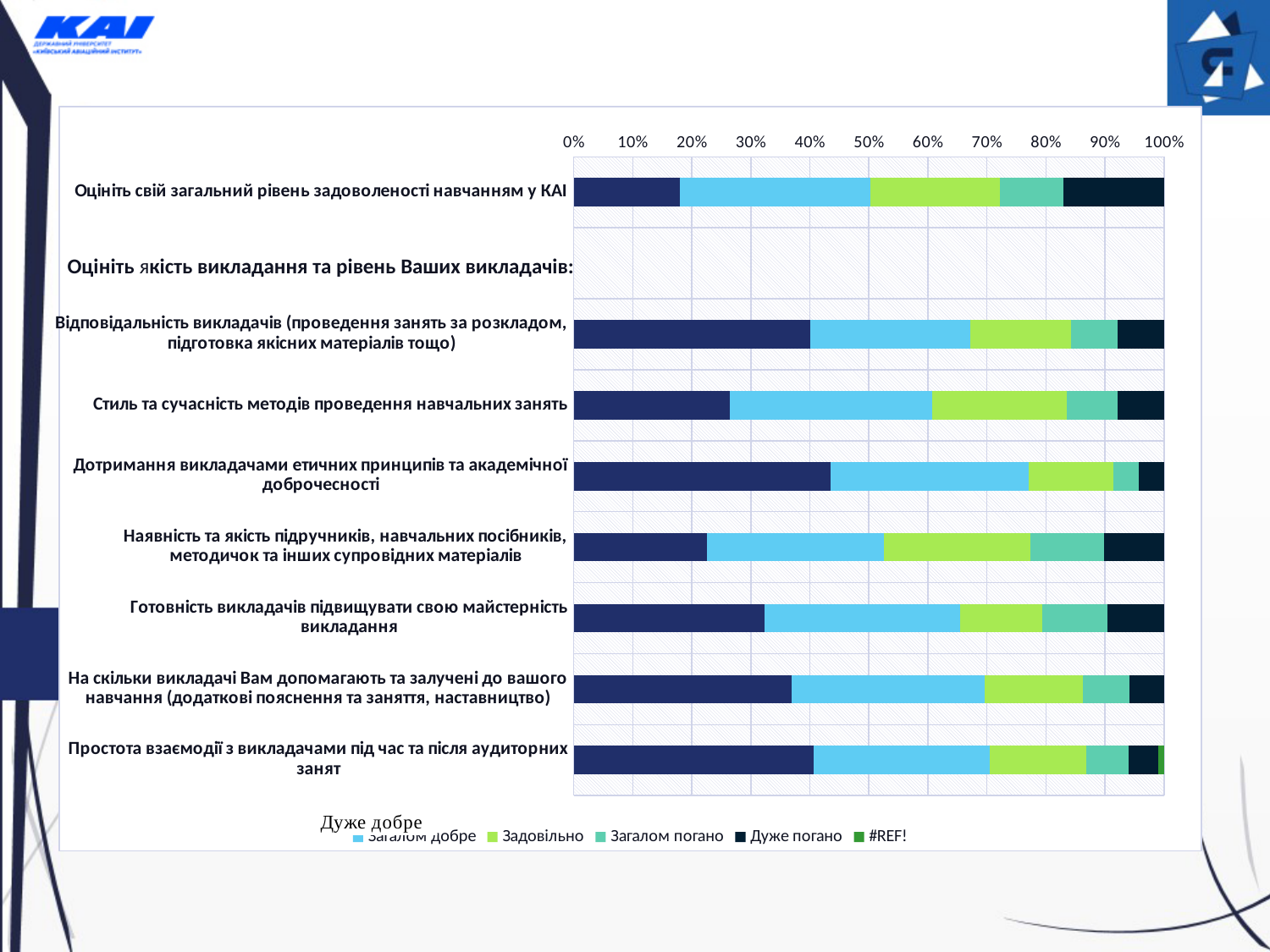
Which has the larger 'Дуже добре' share: 'Дотримання викладачами етичних принципів та академічної доброчесності' or 'Стиль та сучасність методів проведення навчальних занять'? Дотримання викладачами етичних принципів та академічної доброчесності What kind of chart is shown on the slide? stacked bar chart Is the 'Дуже добре' share for 'Дотримання викладачами етичних принципів та академічної доброчесності' greater or less than 40%? greater Which category has the largest 'Дуже погано' segment? Оцініть свій загальний рівень задоволеності навчанням у КАІ Is the 'Дуже добре' share for 'Оцініть свій загальний рівень задоволеності навчанням у КАІ' greater or less than 20%? less Is the 'Дуже добре' share for 'Стиль та сучасність методів проведення навчальних занять' greater or less than 30%? less Which category has the smallest 'Дуже погано' segment? Дотримання викладачами етичних принципів та академічної доброчесності How many series does the legend list? 6 What is the last entry listed in the chart legend? #REF! How many bars are plotted in the chart? 8